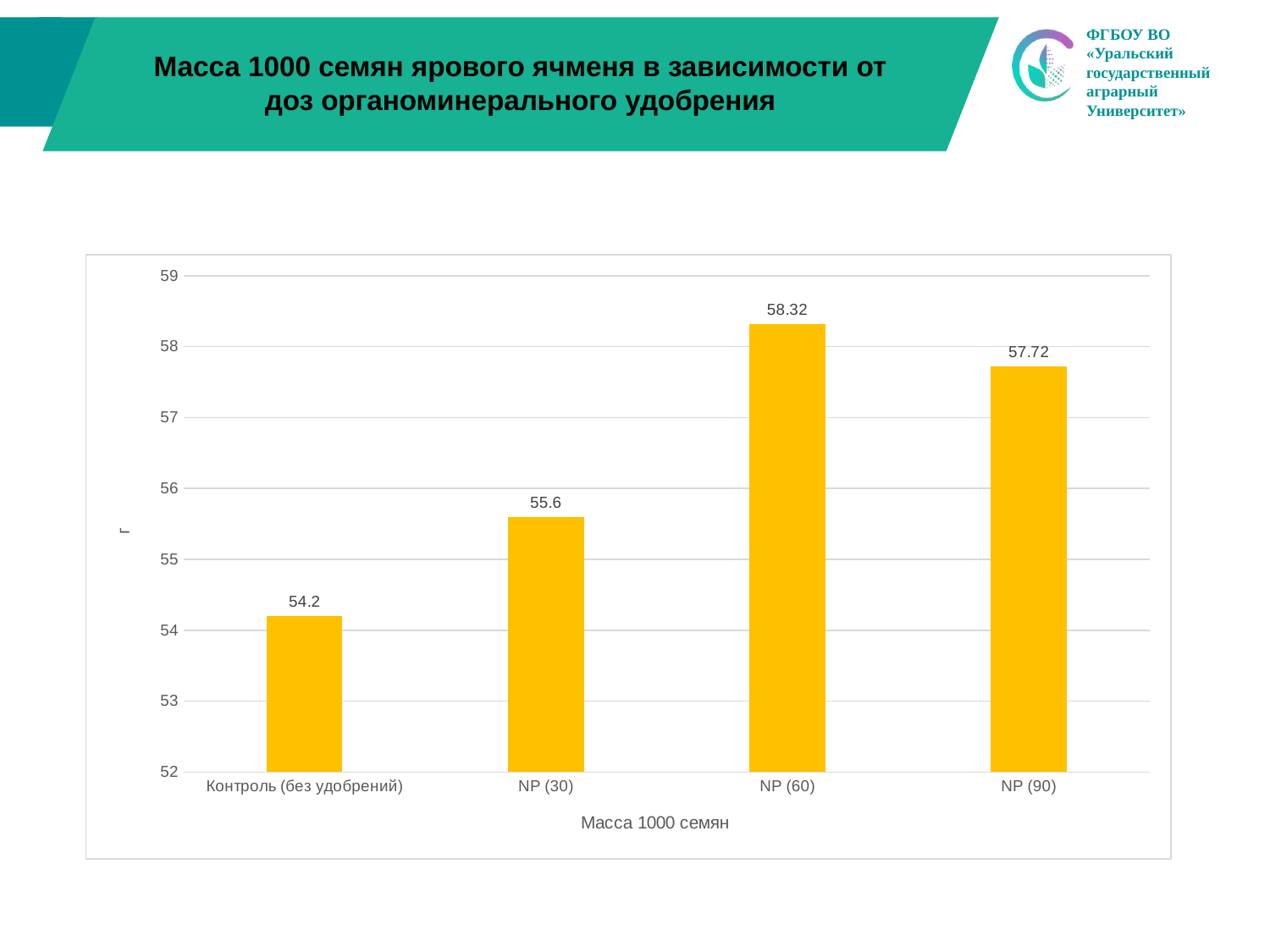
Which is larger, the value for NP (60) or NP (90)? NP (60) What is the value for NP (90)? 57.72 What is the difference between the values for NP (60) and Контроль (без удобрений)? 4.12 What is the value for NP (30)? 55.6 Which category has the lowest value? Контроль (без удобрений) What is the value for Контроль (без удобрений)? 54.2 How many categories are shown on the x axis? 4 What kind of chart is shown on the slide? bar chart Is the value for NP (30) greater or less than 56? less Which category has the highest value? NP (60) What is the value for NP (60)? 58.32 What is the difference between the values for NP (90) and NP (30)? 2.12